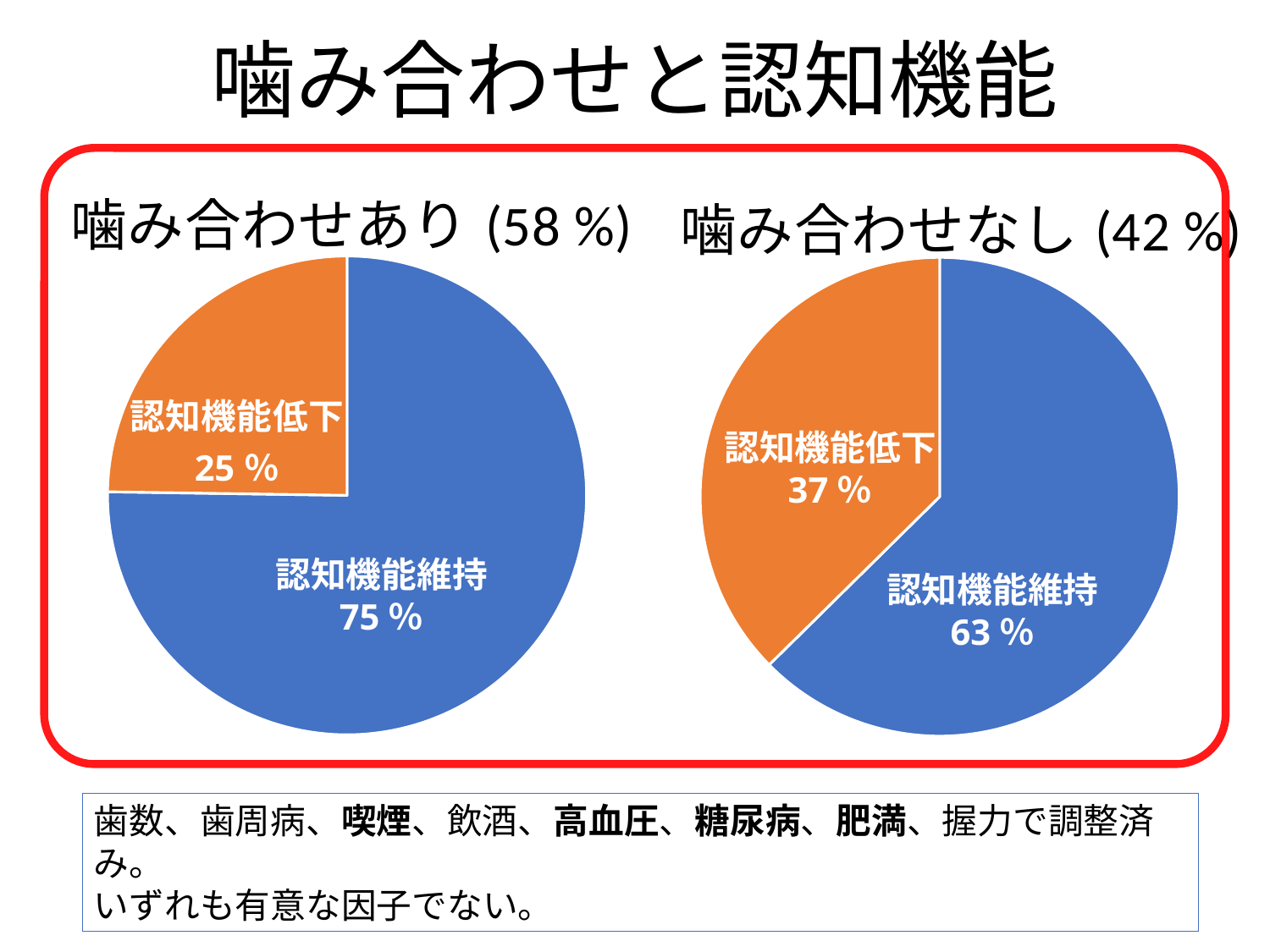
In the 噛み合わせなし (42 %) chart, what is the value for 認知機能維持? 63 % What is the difference between 認知機能維持 and 認知機能低下 in the 噛み合わせなし (42 %) chart? 26 % In the 噛み合わせあり (58 %) chart, which slice is the smallest? 認知機能低下 In the 噛み合わせなし (42 %) chart, which slice is the largest? 認知機能維持 What is the difference between 認知機能維持 and 認知機能低下 in the 噛み合わせあり (58 %) chart? 50 % In the 噛み合わせあり (58 %) chart, what is the value for 認知機能維持? 75 % Which chart has the larger 認知機能低下 share, 噛み合わせあり (58 %) or 噛み合わせなし (42 %)? 噛み合わせなし (42 %) How many slices does the 噛み合わせなし (42 %) chart have? 2 What kind of chart is the 噛み合わせあり (58 %) chart? Pie chart In the 噛み合わせなし (42 %) chart, what is the value for 認知機能低下? 37 % In the 噛み合わせあり (58 %) chart, what is the value for 認知機能低下? 25 % In the 噛み合わせあり (58 %) chart, what colour is the 認知機能低下 slice? Orange